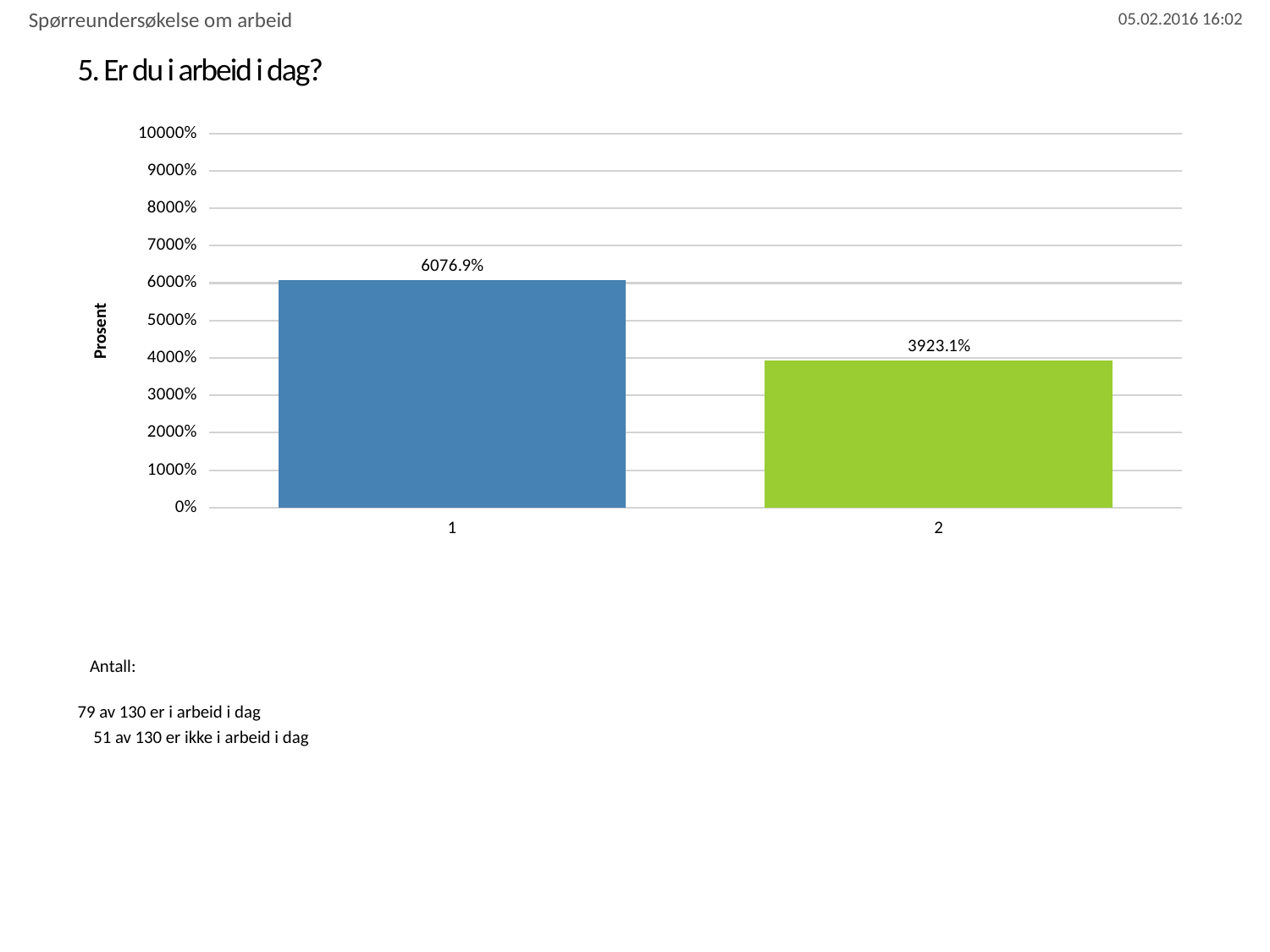
What is the value for category 1? 6076.9% Which category has the highest value? 1 Which is larger, the value for category 1 or category 2? 1 Is the value for category 2 greater or less than 5000%? less Which category has the lowest value? 2 What is the difference between the values for category 1 and category 2? 2153.8% How many categories are shown on the x axis? 2 Is the value for category 1 greater or less than 5000%? greater What kind of chart is shown on the slide? bar chart What colour is the bar for category 1? blue What is the value for category 2? 3923.1% What is the title of the y axis? Prosent